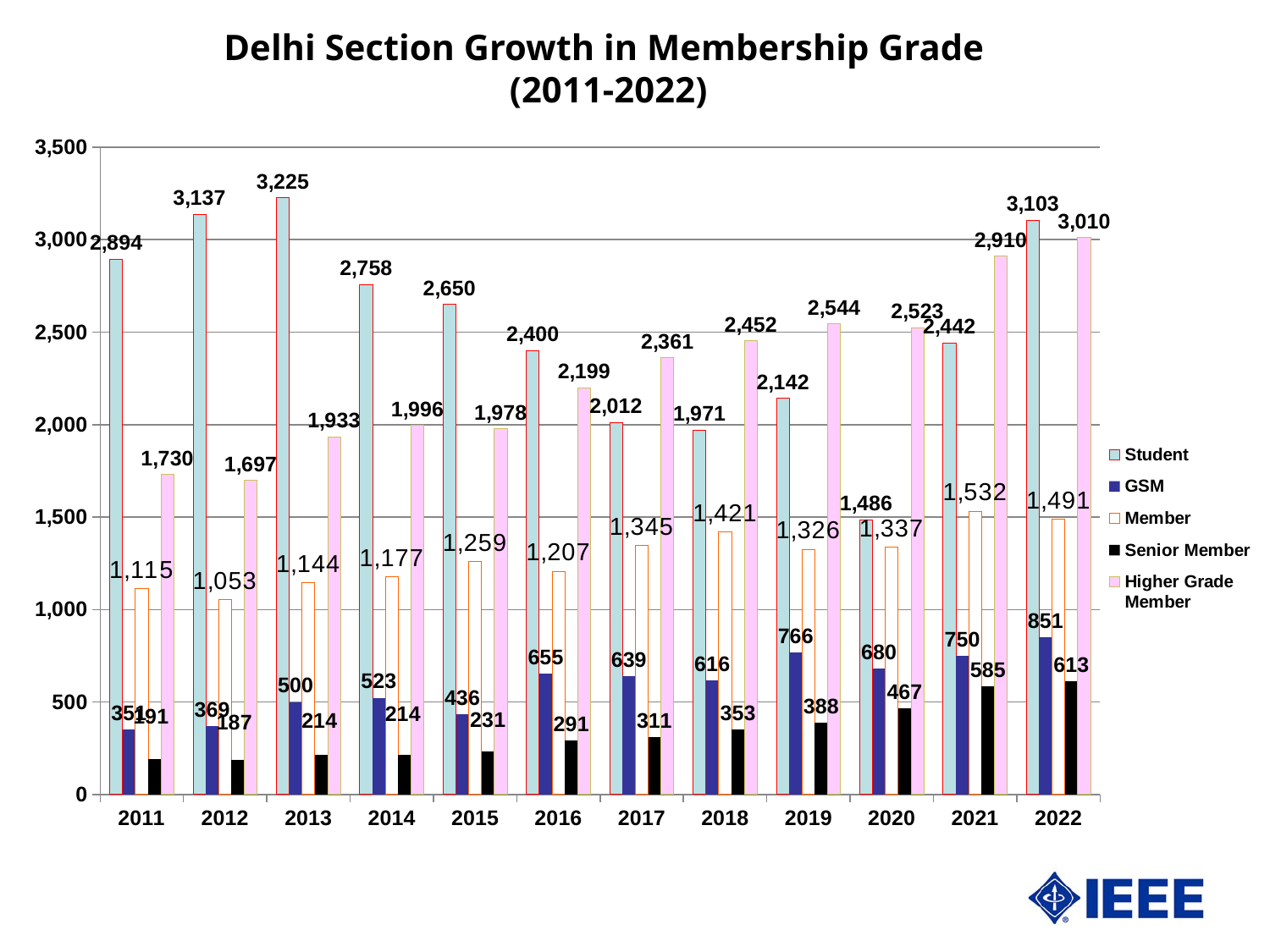
How many series does the legend list? 5 Does the Senior Member value rise or fall from 2015 to 2022? Rise What kind of chart is shown on the slide? Bar chart What is the GSM value for 2019? 766 In which year is the Higher Grade Member value highest? 2022 What is the Higher Grade Member value for 2017? 2,361 What is the difference between the Member value in 2021 and in 2011? 417 In which year is the Senior Member value lowest? 2012 What is the Student value for 2013? 3,225 What is the Senior Member value for 2022? 613 How many years are shown on the x axis? 12 Which is larger in 2022, the Student value or the Higher Grade Member value? Student